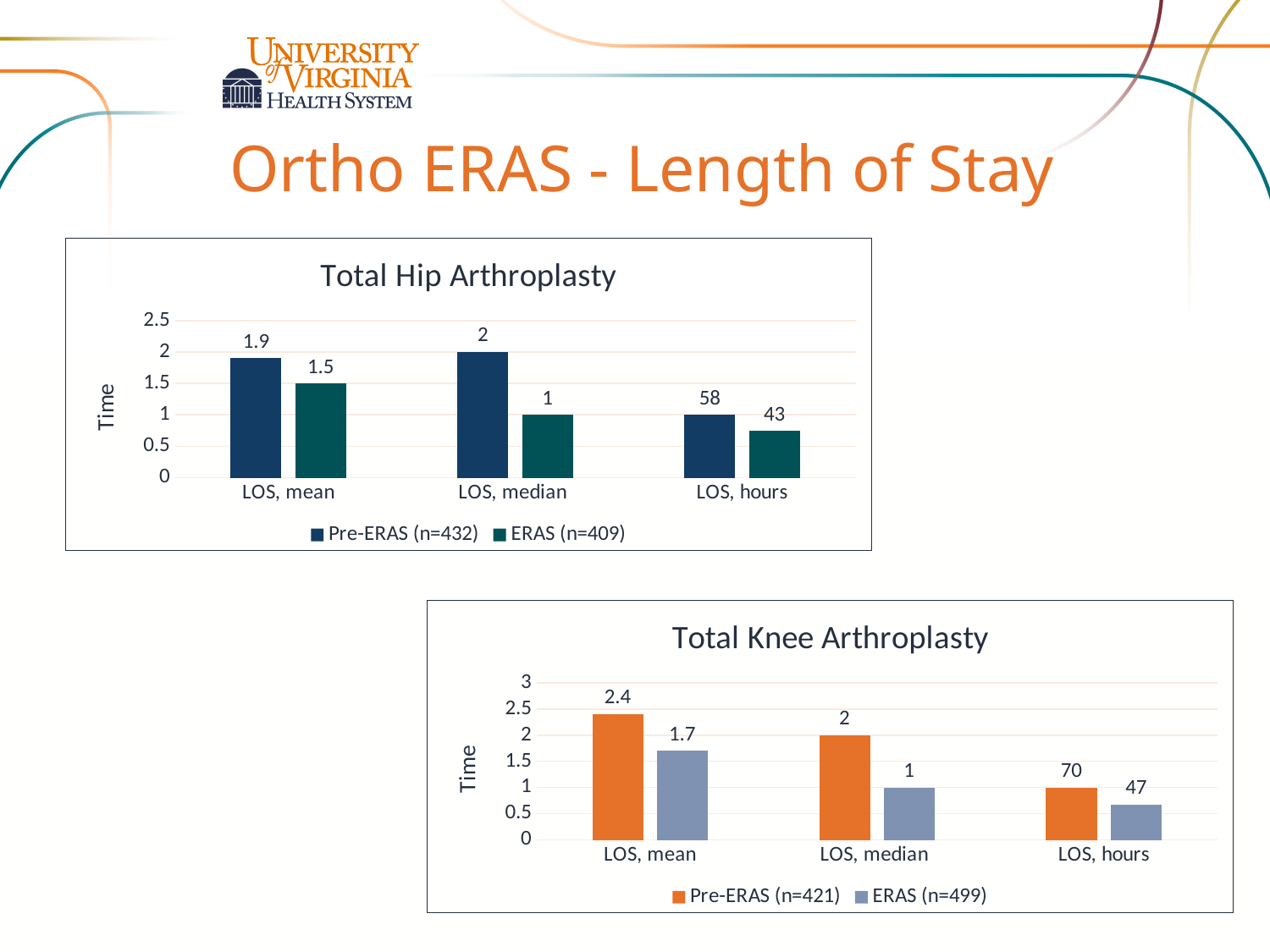
What is the y-axis label of the Total Hip Arthroplasty chart? Time In the Total Hip Arthroplasty chart, what is the LOS, hours value for ERAS (n=409)? 43 In the Total Knee Arthroplasty chart, what is the LOS, mean value for ERAS (n=499)? 1.7 In the Total Knee Arthroplasty chart, how many categories are shown on the x axis? 3 In the Total Hip Arthroplasty chart, how many series does the legend list? 2 In the Total Knee Arthroplasty chart, which series has the larger LOS, median value, Pre-ERAS (n=421) or ERAS (n=499)? Pre-ERAS (n=421) In the Total Knee Arthroplasty chart, what is the LOS, hours value for Pre-ERAS (n=421)? 70 In the Total Hip Arthroplasty chart, what is the LOS, mean value for Pre-ERAS (n=432)? 1.9 In the Total Hip Arthroplasty chart, what is the difference between the Pre-ERAS and ERAS LOS, hours values? 15 What kind of chart is the Total Knee Arthroplasty chart? Bar chart In the Total Hip Arthroplasty chart, what is the LOS, median value for ERAS (n=409)? 1 In the Total Knee Arthroplasty chart, what is the difference between the Pre-ERAS and ERAS LOS, mean values? 0.7